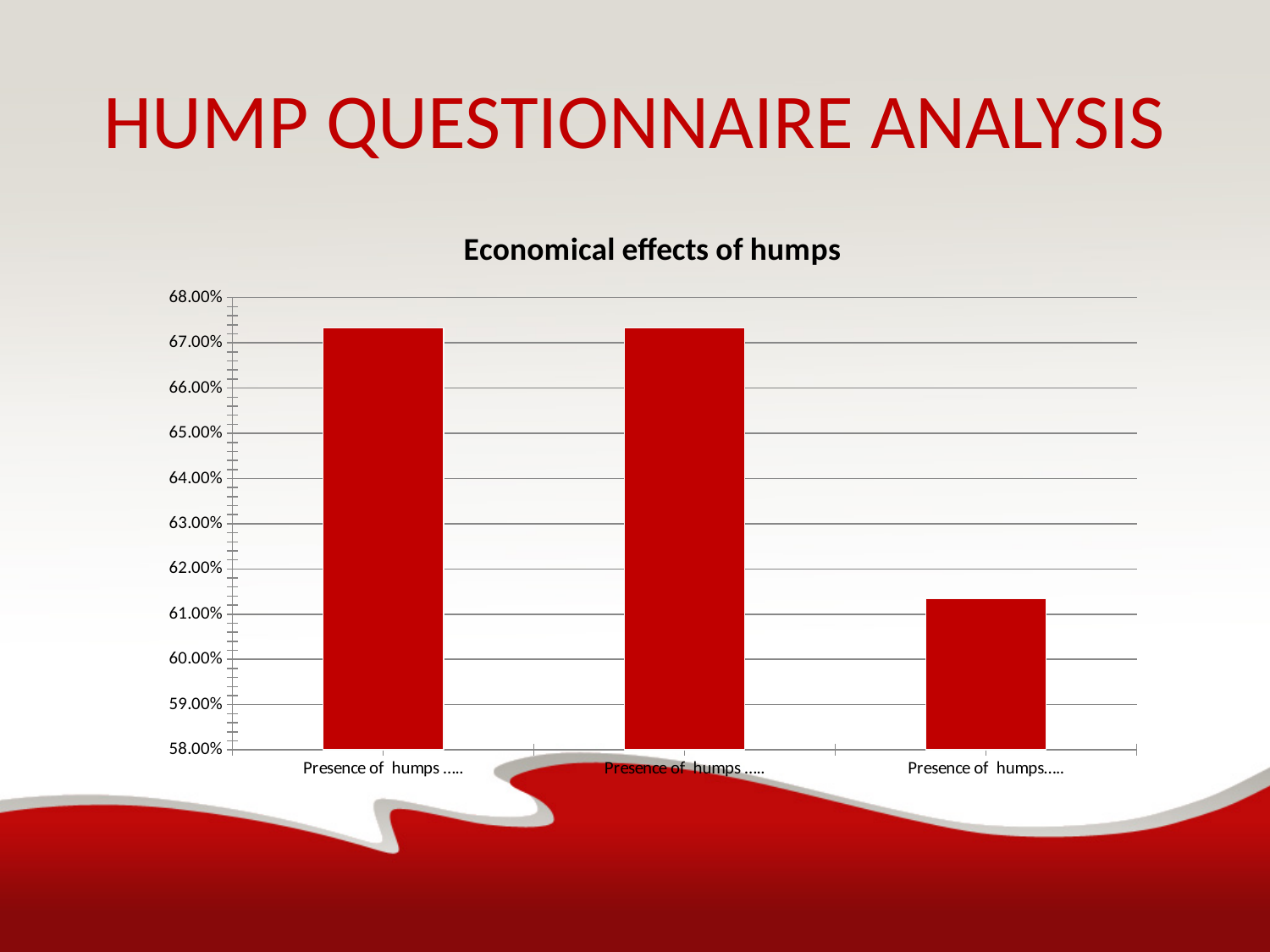
Is the value of the third (rightmost) bar greater or less than 62.00%? less How many bars are plotted in the chart? 3 Which is larger, the first (leftmost) bar or the third (rightmost) bar? the first (leftmost) bar Is the value of the first (leftmost) bar greater or less than 66.00%? greater What kind of chart is shown on the slide? bar chart What is the lowest value shown on the vertical axis? 58.00% What is the title of the chart? Economical effects of humps Which bar is the lowest in the chart? the third (rightmost) bar Is the value of the second (middle) bar greater or less than 68.00%? less